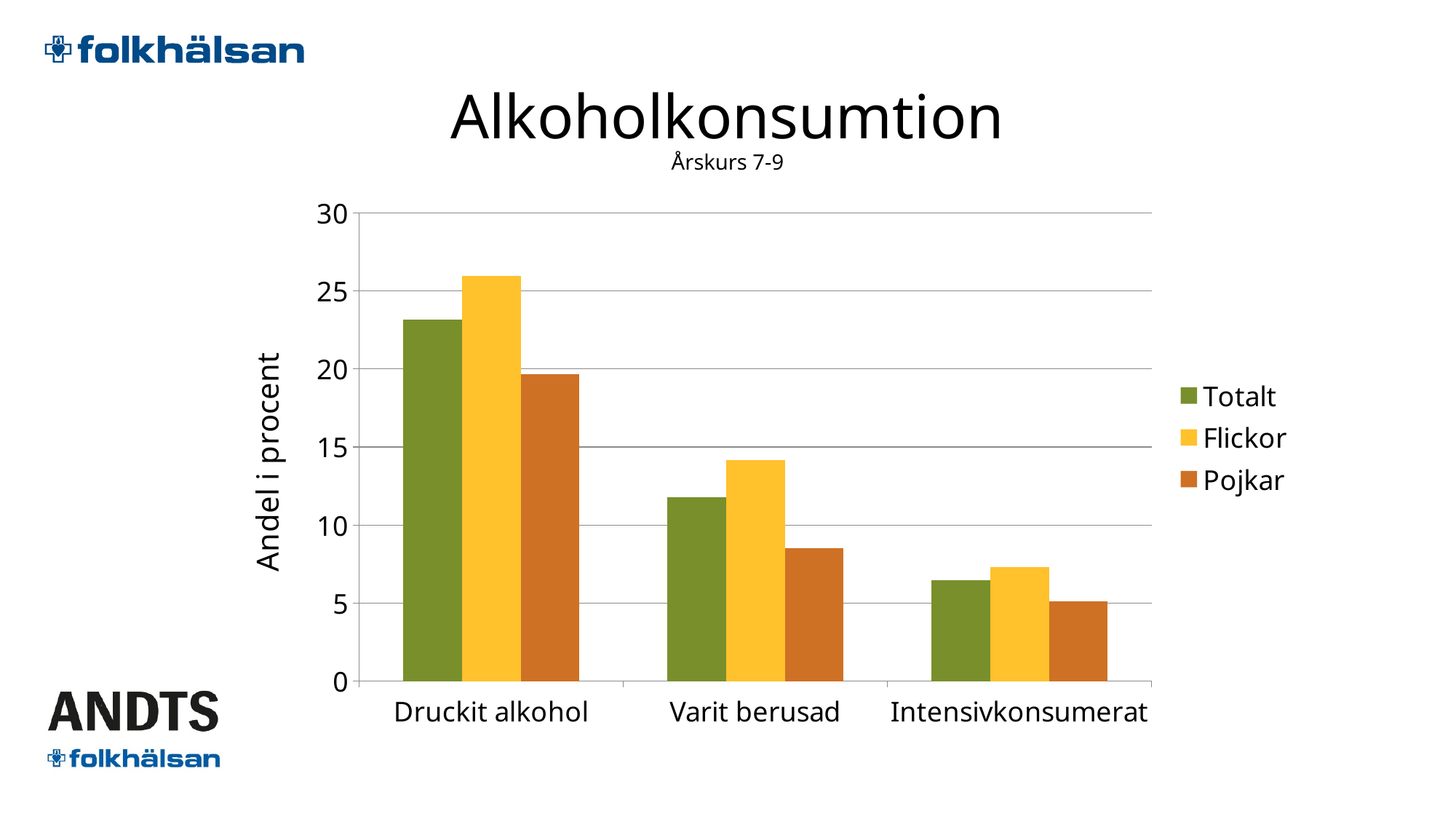
For which category is the Pojkar value lowest? Intensivkonsumerat Is the Flickor value for Druckit alkohol greater or less than 25? greater For Varit berusad, which is larger: Flickor or Pojkar? Flickor Is the Totalt value for Varit berusad greater or less than 10? greater Do the Totalt values rise or fall from Druckit alkohol to Intensivkonsumerat? fall For which category is the Flickor value highest? Druckit alkohol How many categories are shown on the x axis? 3 What is the label on the vertical axis? Andel i procent What kind of chart is shown on the slide? bar chart For Druckit alkohol, which is larger: Totalt or Flickor? Flickor How many series does the legend list? 3